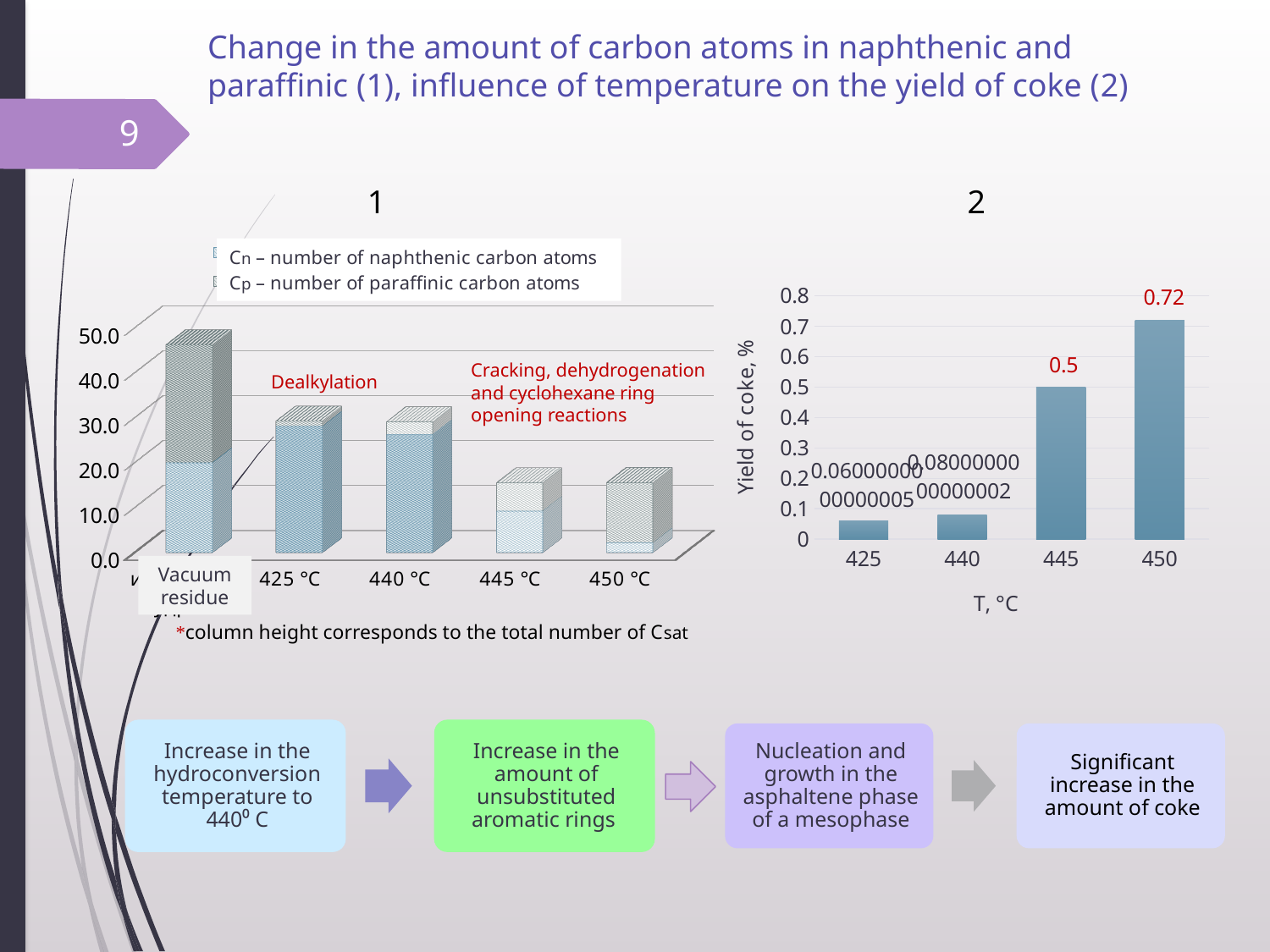
In chart 2 (right), at which temperature is the yield of coke highest? 450 In chart 2 (right), what is the yield of coke at 445 °C? 0.5 What type of chart is chart 2 (right)? bar chart In chart 1 (left), is the total column height for 450 °C greater or less than 20.0? less In chart 2 (right), how many temperature categories are plotted? 4 In chart 2 (right), what is the difference between the yield of coke at 450 °C and at 445 °C? 0.22 In chart 1 (left), how many series does the legend list? 2 In chart 2 (right), what is the yield of coke at 450 °C? 0.72 In chart 1 (left), which category has the tallest column? Vacuum residue In chart 2 (right), is the yield of coke at 440 °C greater or less than 0.1? less In chart 2 (right), at which temperature is the yield of coke lowest? 425 In chart 2 (right), do the values rise or fall as temperature increases along the x axis? rise